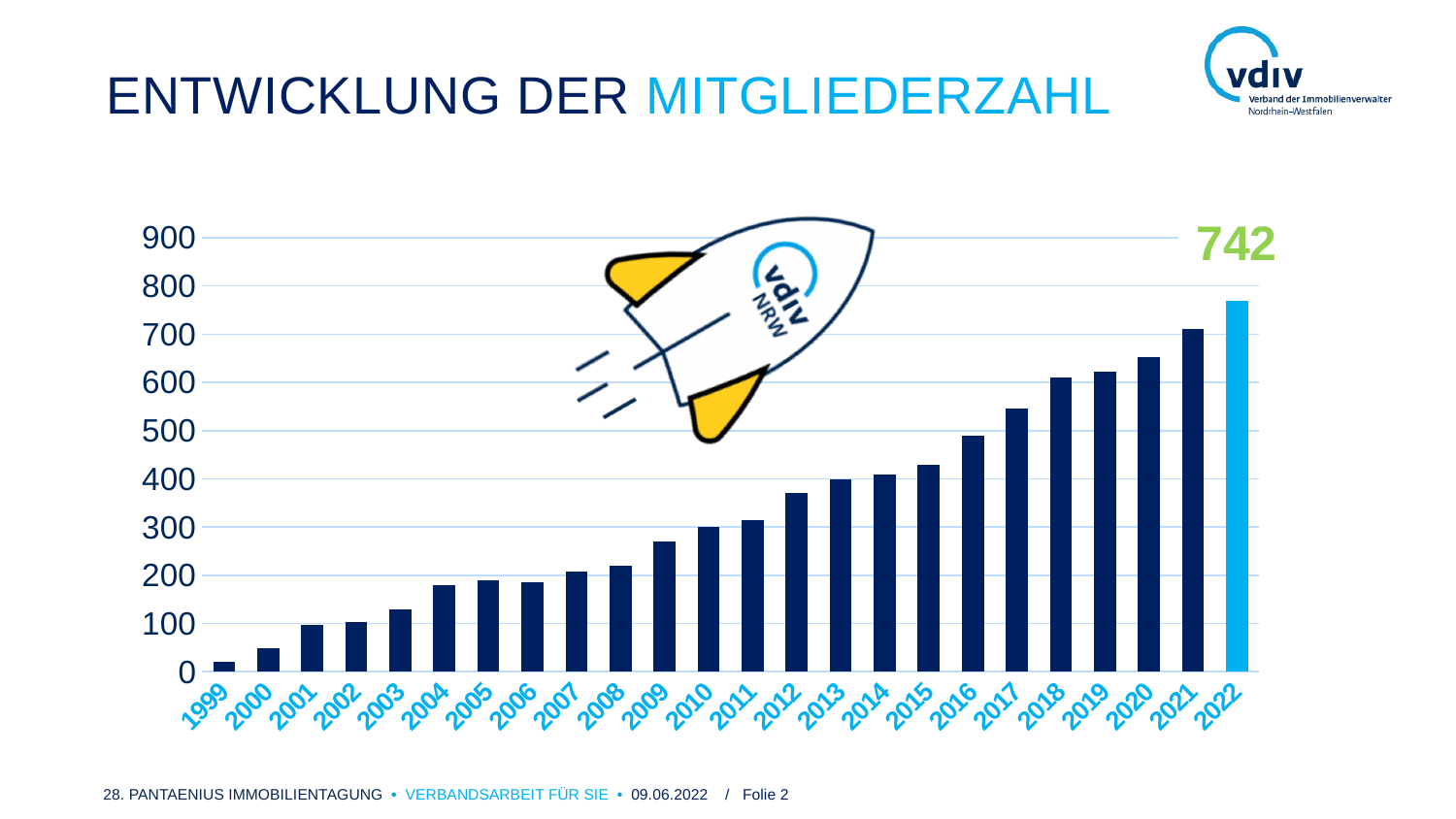
How many years are shown on the x axis? 24 Which year has the lowest bar? 1999 Which year has the larger value, 2010 or 2020? 2020 Is the value for 2004 greater or less than 200? less Which year has the highest bar? 2022 Is the value for 2017 greater or less than 500? greater Do the values generally rise or fall from 1999 to 2022? Rise What is the value shown for 2022? 742 Is the value for 2012 greater or less than 400? less What kind of chart is shown on the slide? Bar chart Which year's bar is shown in a lighter blue than the others? 2022 What is the title of the slide? Entwicklung der Mitgliederzahl